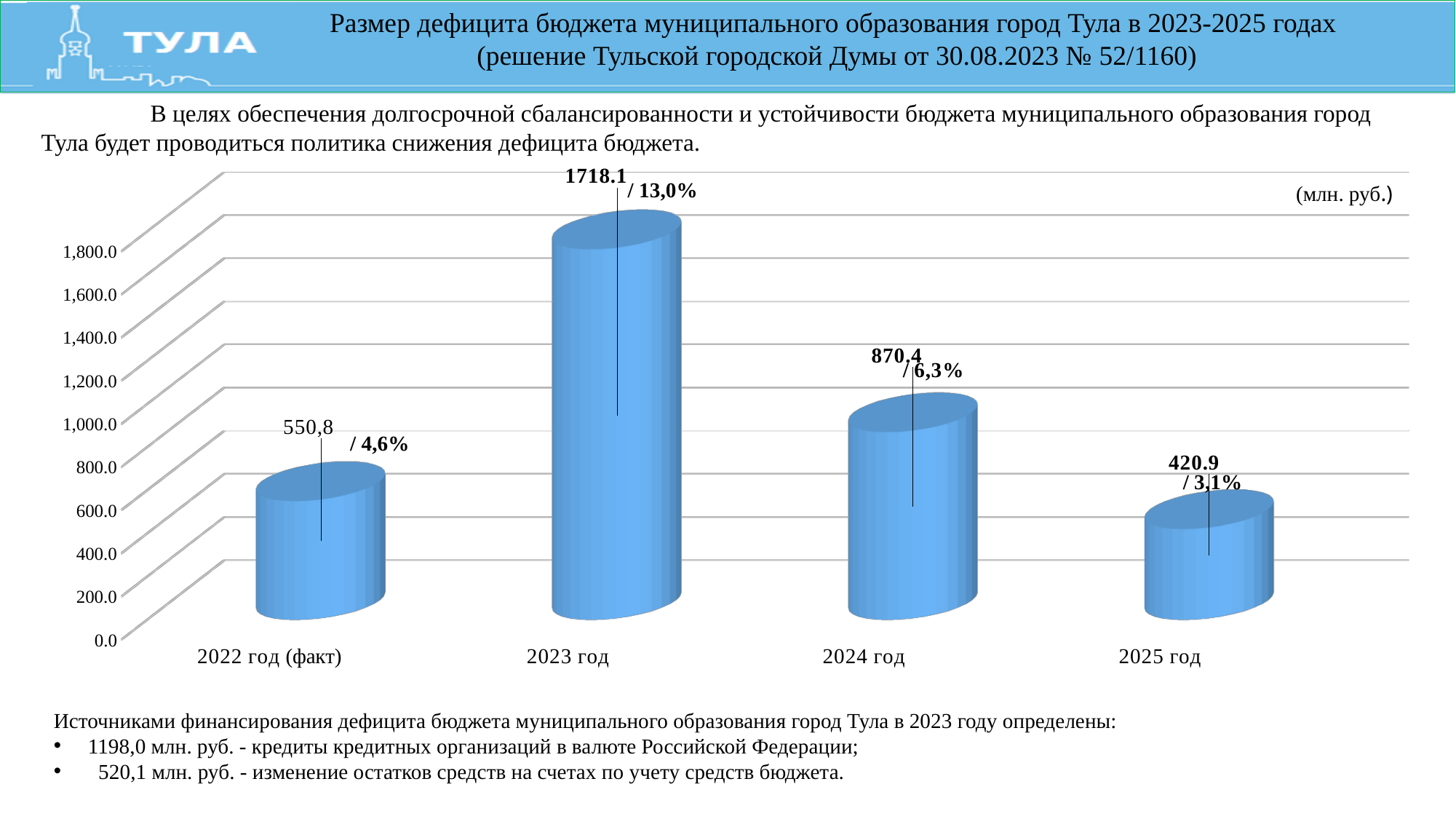
What is the difference between the values for 2023 год and 2024 год? 847.7 Which year has the lowest budget deficit value? 2025 год Do the values rise or fall from 2023 год to 2025 год? fall Which year has the highest budget deficit value? 2023 год What percentage is shown next to the 2023 год bar? 13,0% What is the budget deficit value shown for 2023 год? 1718.1 Which is larger, the value for 2022 год (факт) or the value for 2024 год? 2024 год Is the value for 2023 год greater or less than 1,600.0? greater What is the value shown for 2025 год? 420.9 What percentage is shown next to the 2024 год bar? 6,3% How many years (categories) are shown on the chart? 4 What is the value shown for 2022 год (факт)? 550,8